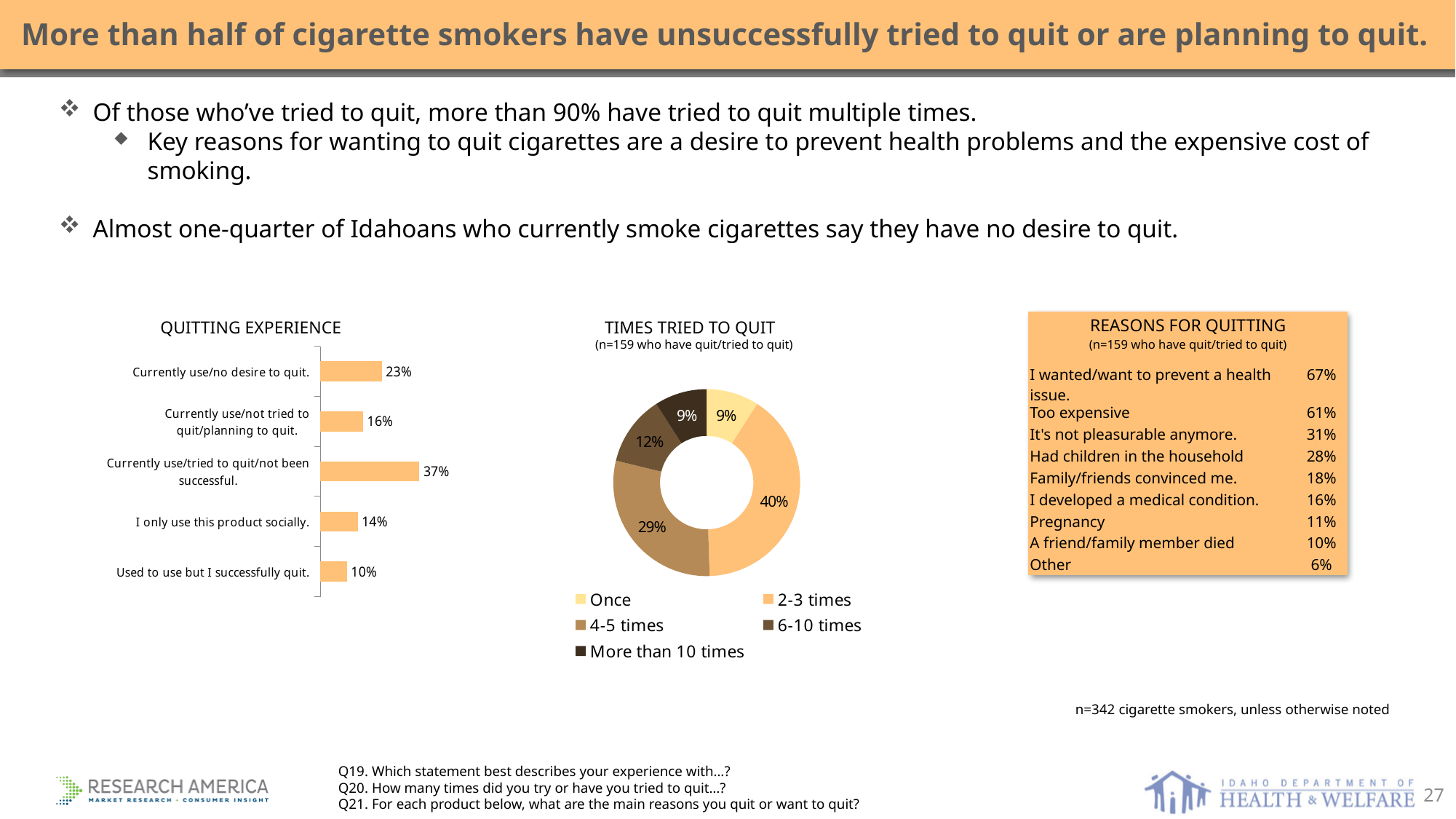
In the QUITTING EXPERIENCE chart, what percentage of cigarette smokers currently use/tried to quit/not been successful? 37% In the QUITTING EXPERIENCE chart, how many categories are shown? 5 In the TIMES TRIED TO QUIT chart, how many categories does the legend list? 5 In the TIMES TRIED TO QUIT chart, what percentage tried to quit 4-5 times? 29% In the TIMES TRIED TO QUIT chart, which category has the largest share? 2-3 times In the QUITTING EXPERIENCE chart, which category has the highest percentage? Currently use/tried to quit/not been successful. In the QUITTING EXPERIENCE chart, which category has the lowest percentage? Used to use but I successfully quit. In the TIMES TRIED TO QUIT chart, which is larger: 6-10 times or 4-5 times? 4-5 times In the QUITTING EXPERIENCE chart, what is the difference between 'Currently use/no desire to quit' and 'I only use this product socially'? 9% What type of chart is the QUITTING EXPERIENCE chart? Bar chart In the QUITTING EXPERIENCE chart, what percentage used to use but successfully quit? 10% In the TIMES TRIED TO QUIT chart, what share of respondents tried to quit 2-3 times? 40%